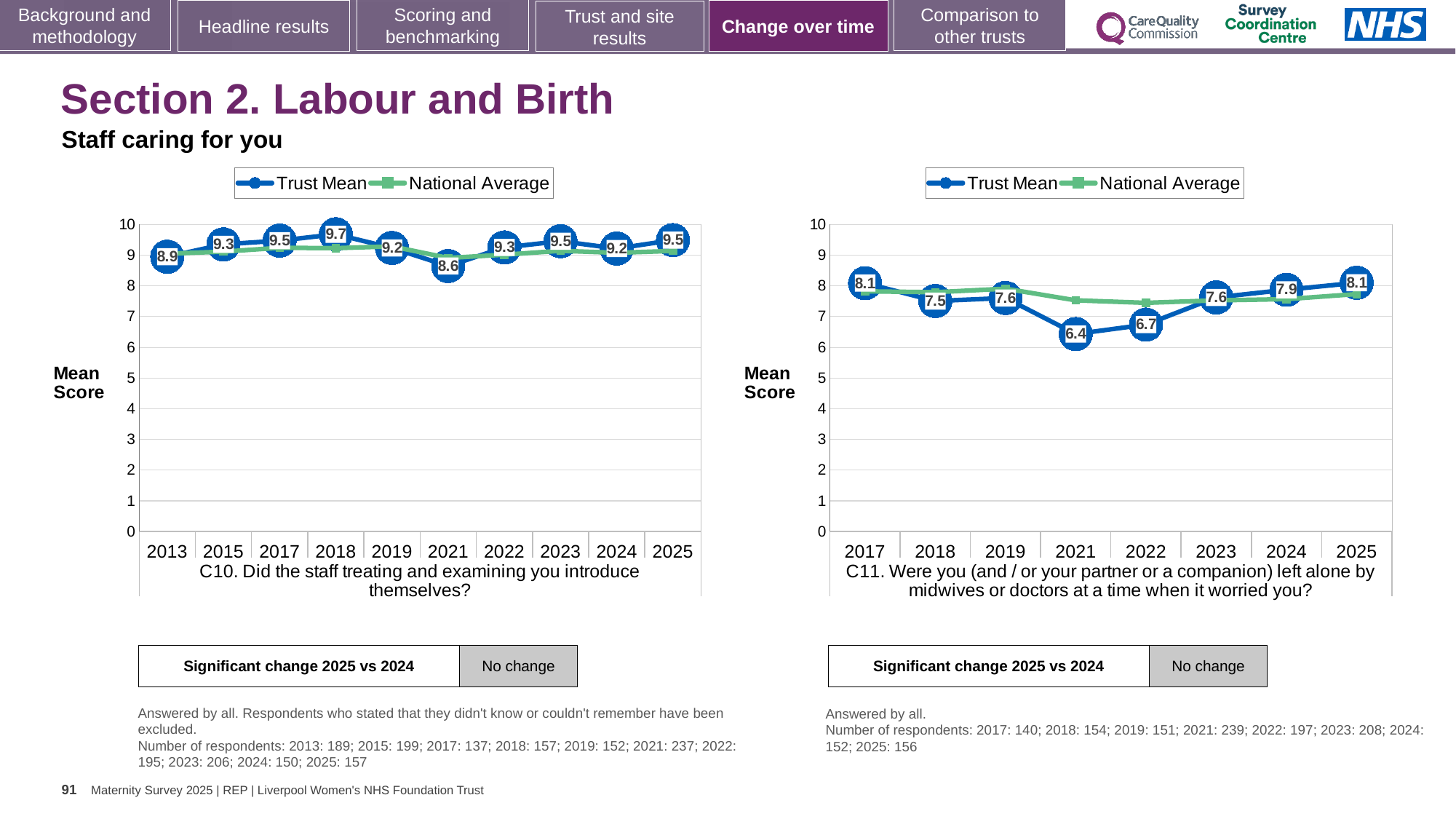
In the C11 chart (right), is the National Average for 2021 greater or less than 7? greater In the C10 chart (left), what is the Trust Mean score for 2018? 9.7 In the C10 chart (left), what is the Trust Mean score for 2021? 8.6 In the C11 chart (right), which year has the lowest Trust Mean score? 2021 In the C10 chart (left), how many years are shown on the x axis? 10 In the C10 chart (left), which year has the lowest Trust Mean score? 2021 In the C11 chart (right), what is the Trust Mean score for 2025? 8.1 In the C10 chart (left), what is the difference between the Trust Mean scores for 2018 and 2021? 1.1 In the C10 chart (left), which year has the highest Trust Mean score? 2018 In the C11 chart (right), is the Trust Mean score for 2024 greater or less than the score for 2022? greater In the C11 chart (right), what is the Trust Mean score for 2021? 6.4 How many series does the legend of the C11 chart (right) list? 2